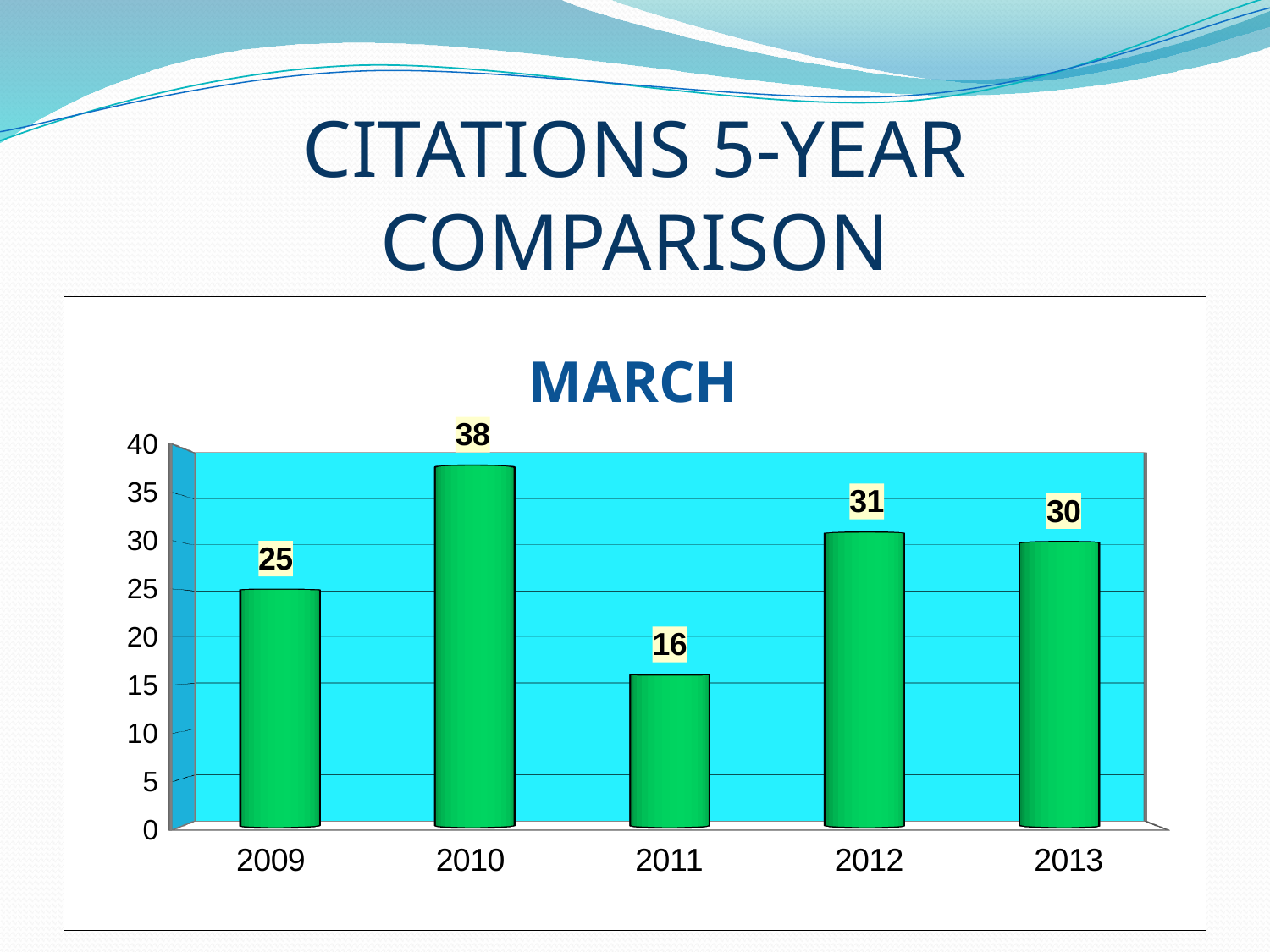
What is the difference between the values for 2012 and 2009? 6 Is the value for 2010 greater or less than 35? greater What is the value for 2011? 16 How many years are shown on the x axis? 5 What is the difference between the values for 2010 and 2011? 22 Which is larger, the value for 2012 or the value for 2013? 2012 What is the title of the chart? MARCH What kind of chart is this? bar chart What is the value for 2013? 30 Which year has the lowest value? 2011 Which year has the highest value? 2010 What is the value for 2009? 25